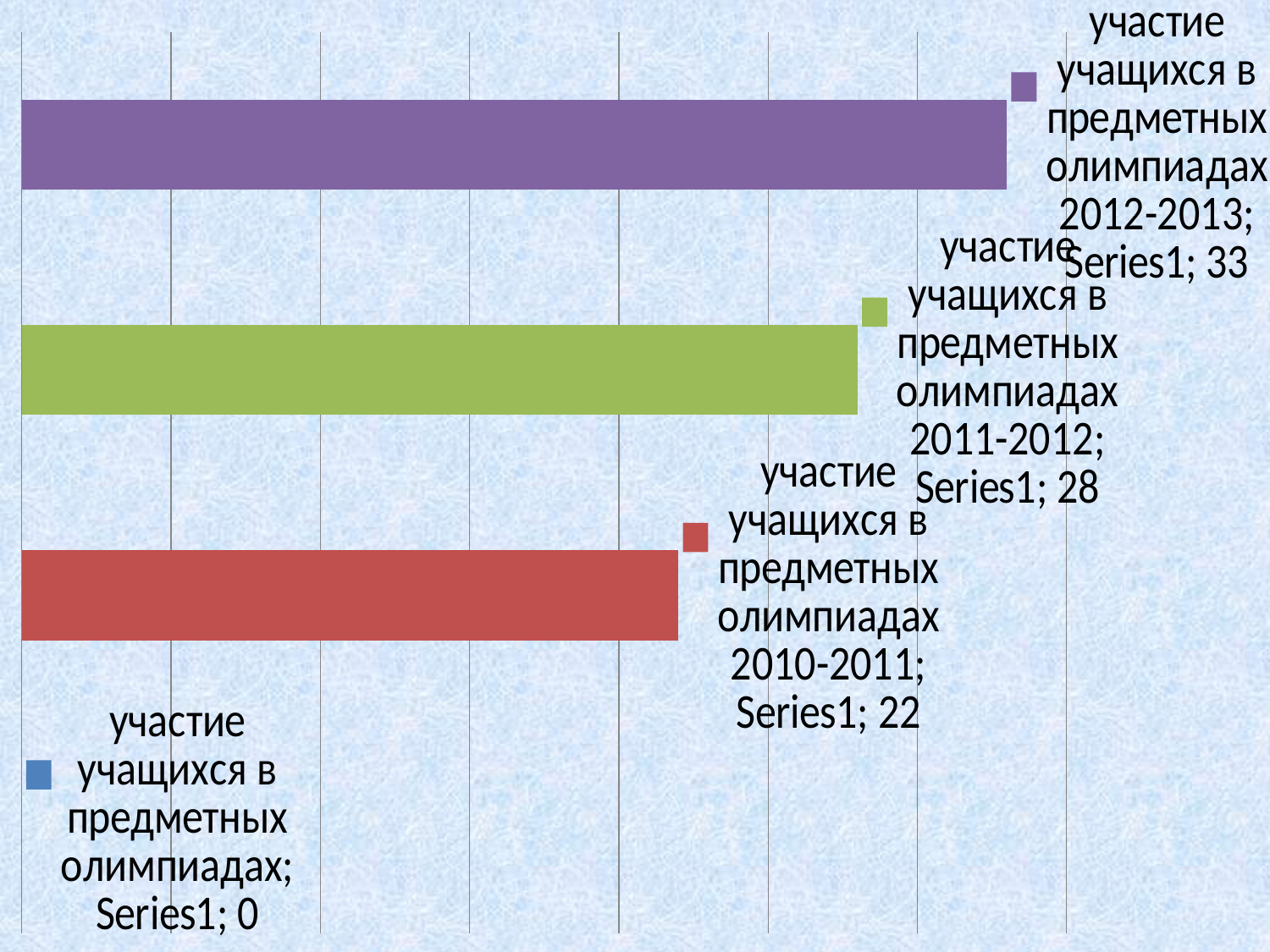
Which is larger, the value for 2011-2012 or the value for 2010-2011? 2011-2012 What is the difference between the values for 2012-2013 and 2010-2011? 11 What kind of chart is shown on the slide? bar chart What is the difference between the values for 2012-2013 and 2011-2012? 5 What series name appears in the data labels? Series1 Which category has the highest value? участие учащихся в предметных олимпиадах 2012-2013 Do the values rise or fall from 2010-2011 to 2012-2013? rise Which of the categories with a year has the lowest value? участие учащихся в предметных олимпиадах 2010-2011 What is the value for участие учащихся в предметных олимпиадах 2012-2013? 33 What is the value for участие учащихся в предметных олимпиадах 2010-2011? 22 What is the value for участие учащихся в предметных олимпиадах 2011-2012? 28 What is the value for the category labelled участие учащихся в предметных олимпиадах (with no year)? 0